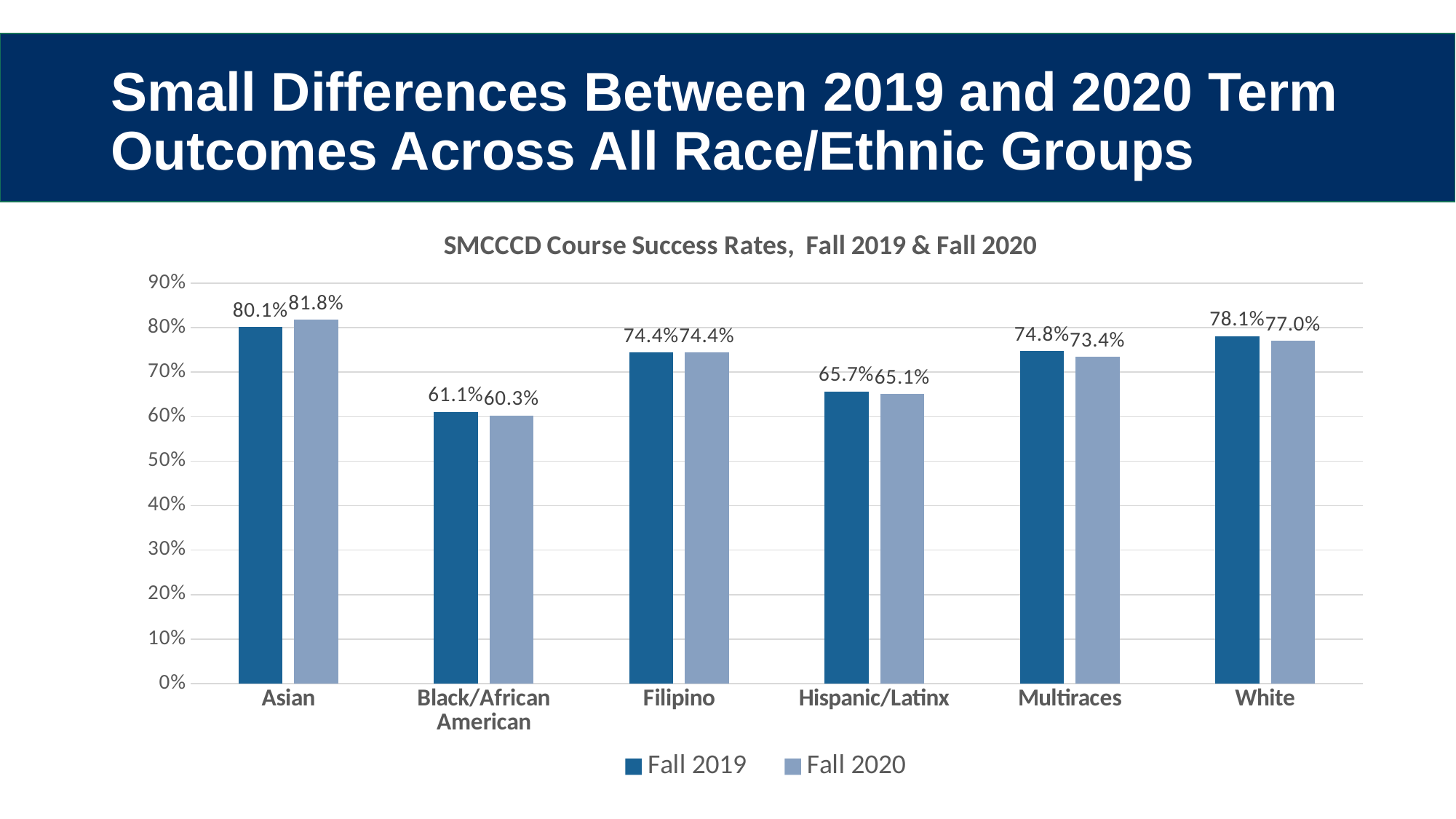
Which race/ethnic group has the highest Fall 2020 course success rate? Asian Is the Fall 2019 value for Black/African American students greater or less than 70%? less How many series does the legend list? 2 What kind of chart is shown on the slide? Bar chart What is the Fall 2020 course success rate for White students? 77.0% Which is larger for White students: the Fall 2019 rate or the Fall 2020 rate? Fall 2019 Which race/ethnic group has the lowest Fall 2019 course success rate? Black/African American What is the difference between the Fall 2019 and Fall 2020 success rates for Multiraces students? 1.4% What is the Fall 2019 course success rate for Asian students? 80.1% How many race/ethnic groups are shown on the x axis? 6 What is the Fall 2020 course success rate for Hispanic/Latinx students? 65.1% What is the difference between the Fall 2020 and Fall 2019 success rates for Asian students? 1.7%